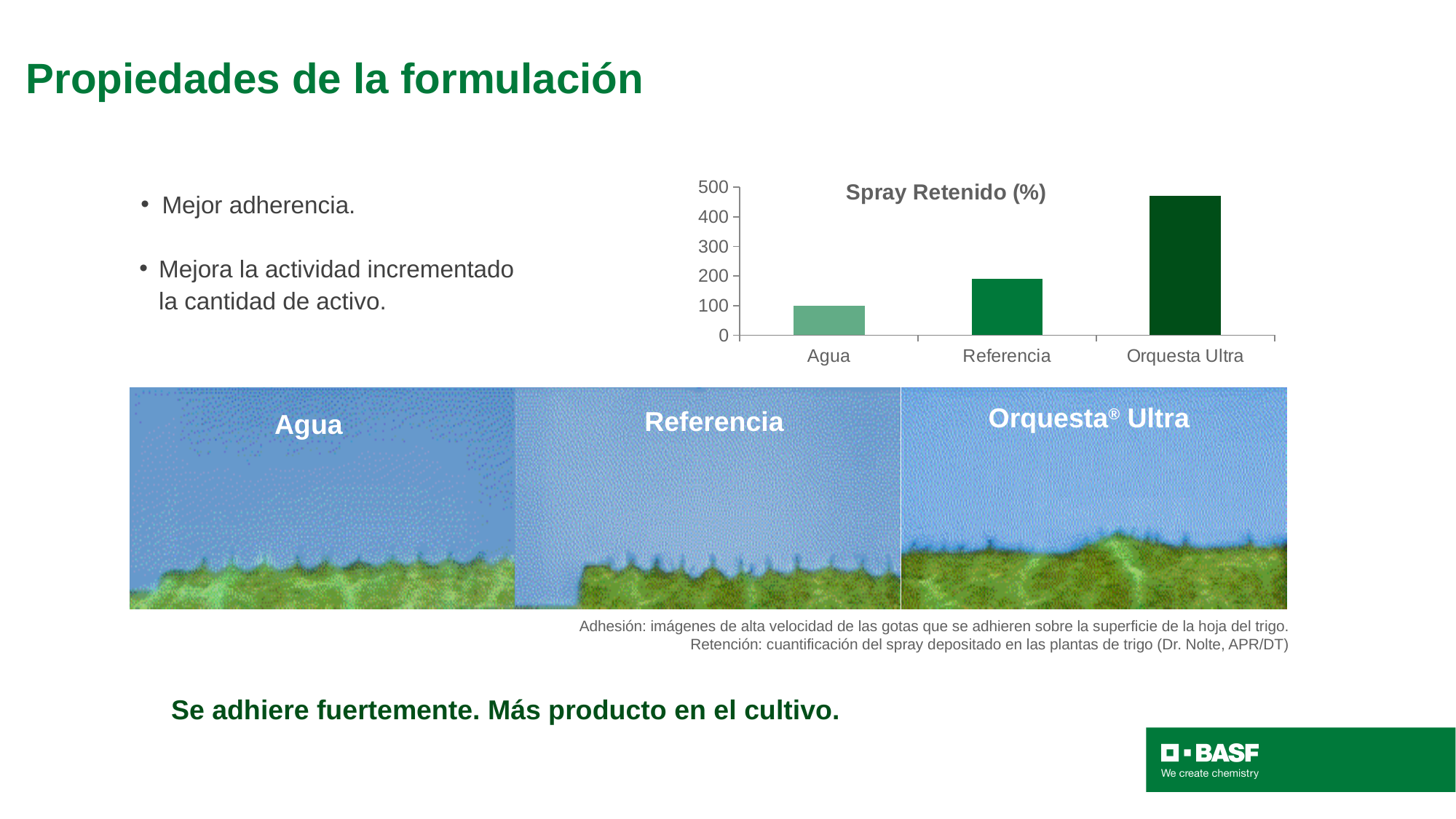
What is the title of the chart? Spray Retenido (%) What is the value for Agua in the chart? 100 Is the value for Orquesta Ultra greater or less than 400? greater Which category has the highest value in the chart? Orquesta Ultra Do the values rise or fall from Agua to Orquesta Ultra along the x axis? rise Is the value for Referencia greater or less than 100? greater What is the highest value shown on the chart's vertical axis? 500 Which is larger, the value for Referencia or the value for Orquesta Ultra? Orquesta Ultra What type of chart is shown on the slide? bar chart How many categories are plotted in the chart? 3 Which category has the lowest value in the chart? Agua